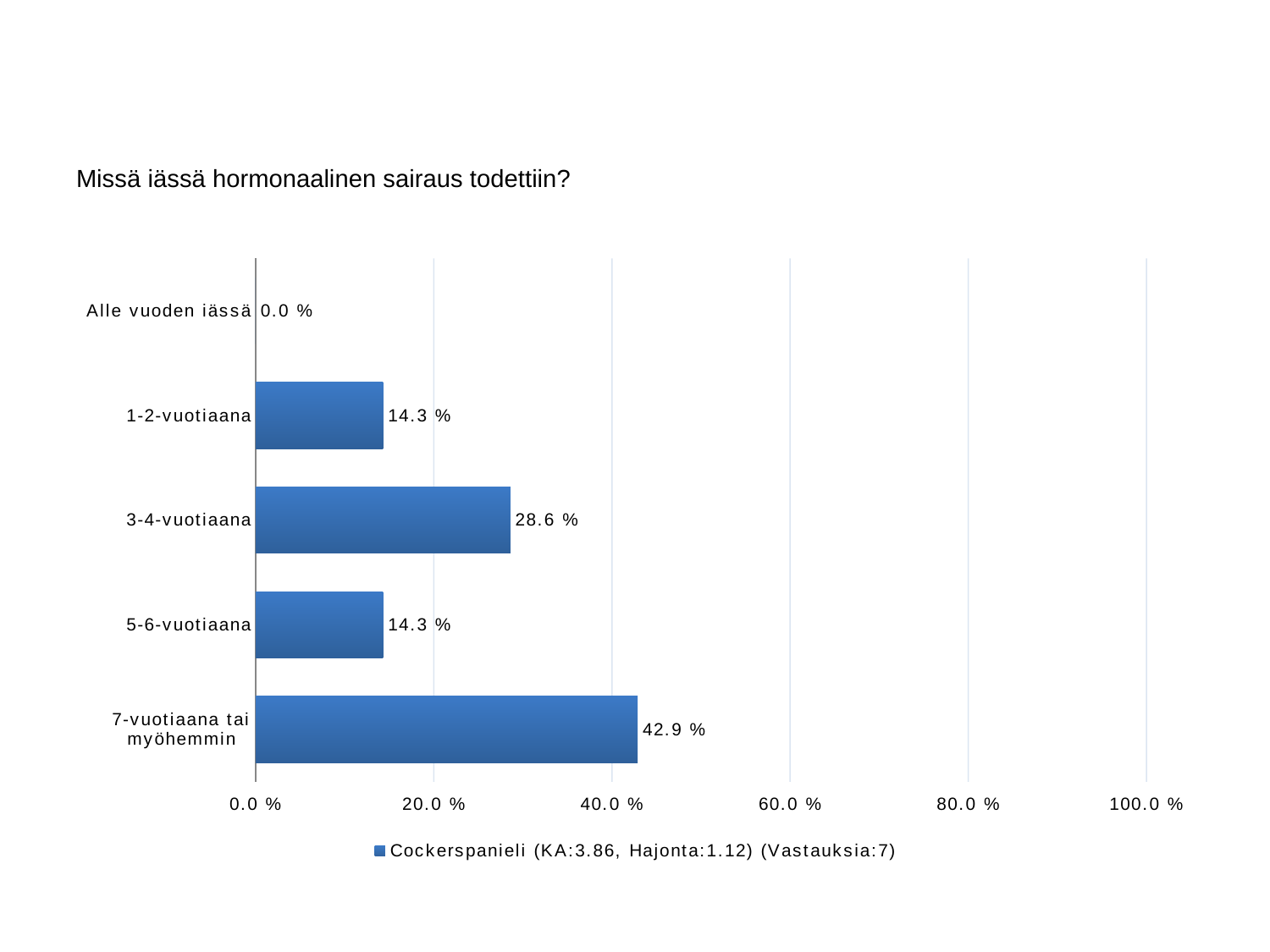
What is the value for "3-4-vuotiaana"? 28.6 % Which category has the lowest value? Alle vuoden iässä How many categories are shown in the chart? 5 What is the value for "1-2-vuotiaana"? 14.3 % Which category has the highest value? 7-vuotiaana tai myöhemmin Which is larger, the value for "3-4-vuotiaana" or the value for "5-6-vuotiaana"? 3-4-vuotiaana Is the value for "7-vuotiaana tai myöhemmin" greater or less than 40.0 %? greater What kind of chart is shown on the slide? bar chart What is the difference between the values for "7-vuotiaana tai myöhemmin" and "3-4-vuotiaana"? 14.3 % What is the value for "7-vuotiaana tai myöhemmin"? 42.9 % What is the value for "Alle vuoden iässä"? 0.0 % What is the title of the chart? Missä iässä hormonaalinen sairaus todettiin?